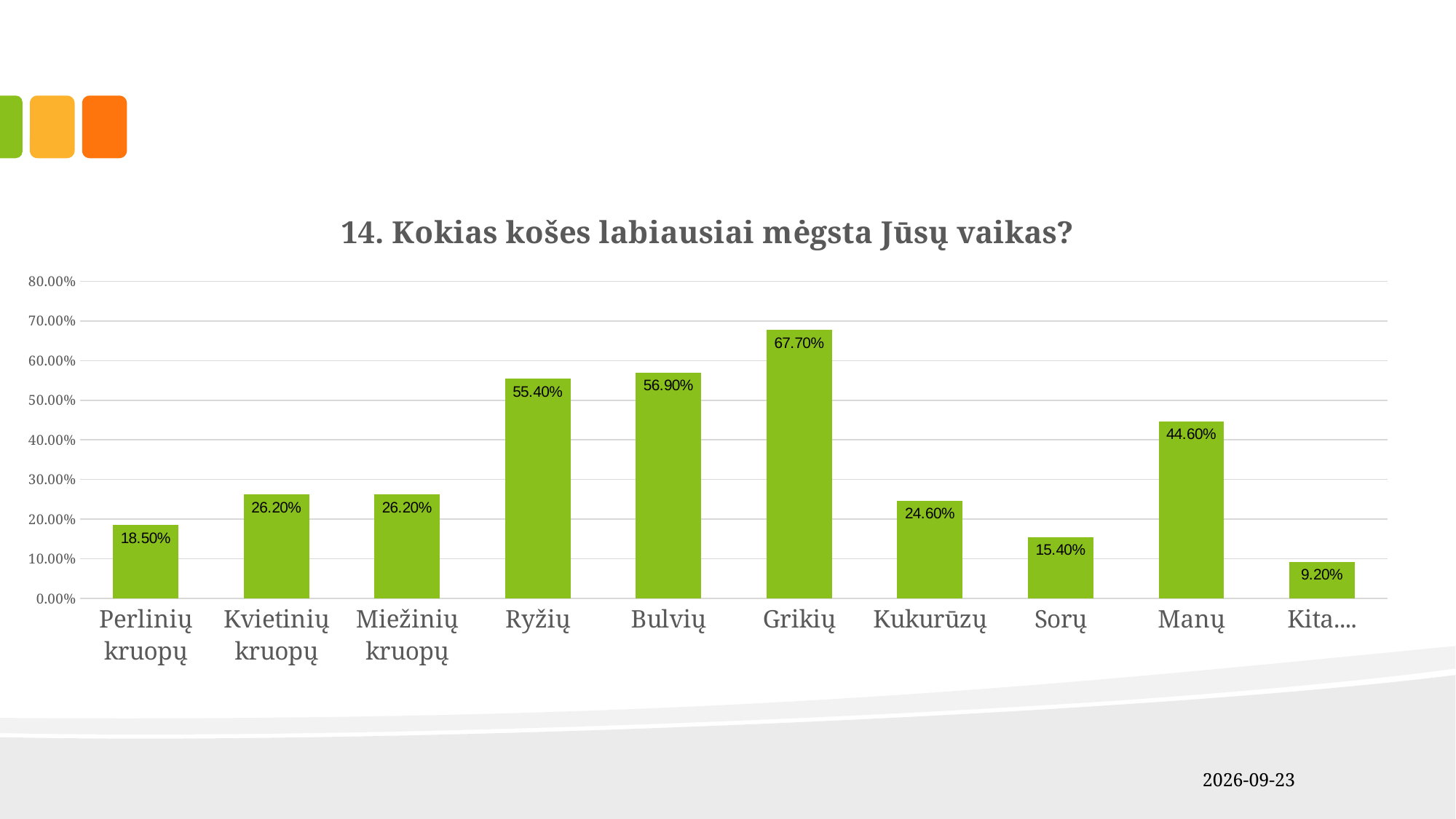
What is the value for Perlinių kruopų? 18.50% Which is larger, the value for Ryžių or the value for Bulvių? Bulvių Which category has the highest value? Grikių What kind of chart is shown on the slide? bar chart What is the difference between the values for Grikių and Bulvių? 10.80% What is the value for Manų? 44.60% What is the title of the chart? 14. Kokias košes labiausiai mėgsta Jūsų vaikas? What is the difference between the values for Kukurūzų and Sorų? 9.20% What is the value for Grikių? 67.70% Is the value for Manų greater or less than 40.00%? greater Which category has the lowest value? Kita.... How many categories are shown on the x axis? 10